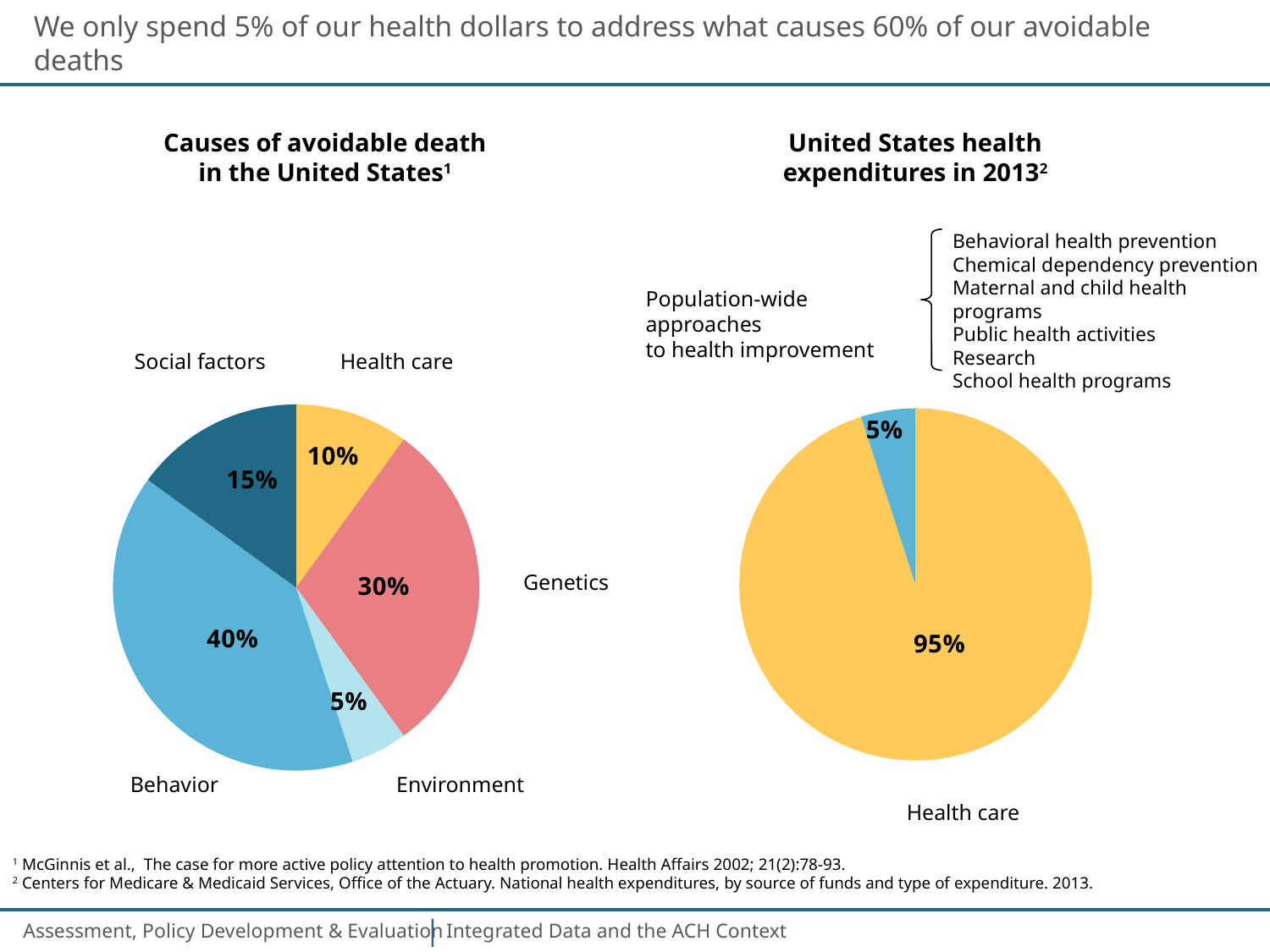
How many categories are shown in the 'Causes of avoidable death in the United States' pie chart? 5 In the 'Causes of avoidable death in the United States' pie chart, which is larger, Genetics or Social factors? Genetics In the 'Causes of avoidable death in the United States' pie chart, which category has the largest share? Behavior In the 'Causes of avoidable death in the United States' pie chart, what share is attributed to Health care? 10% In the 'United States health expenditures in 2013' pie chart, what share goes to Health care? 95% In the 'Causes of avoidable death in the United States' pie chart, what is the difference between the Behavior share and the Social factors share? 25% How many pie charts are shown on the slide? 2 In the 'Causes of avoidable death in the United States' pie chart, what share is attributed to Genetics? 30% What type of chart is used for 'United States health expenditures in 2013'? Pie chart In the 'Causes of avoidable death in the United States' pie chart, which category has the smallest share? Environment In the 'Causes of avoidable death in the United States' pie chart, what share is attributed to Behavior? 40% In the 'United States health expenditures in 2013' pie chart, what share goes to population-wide approaches to health improvement? 5%